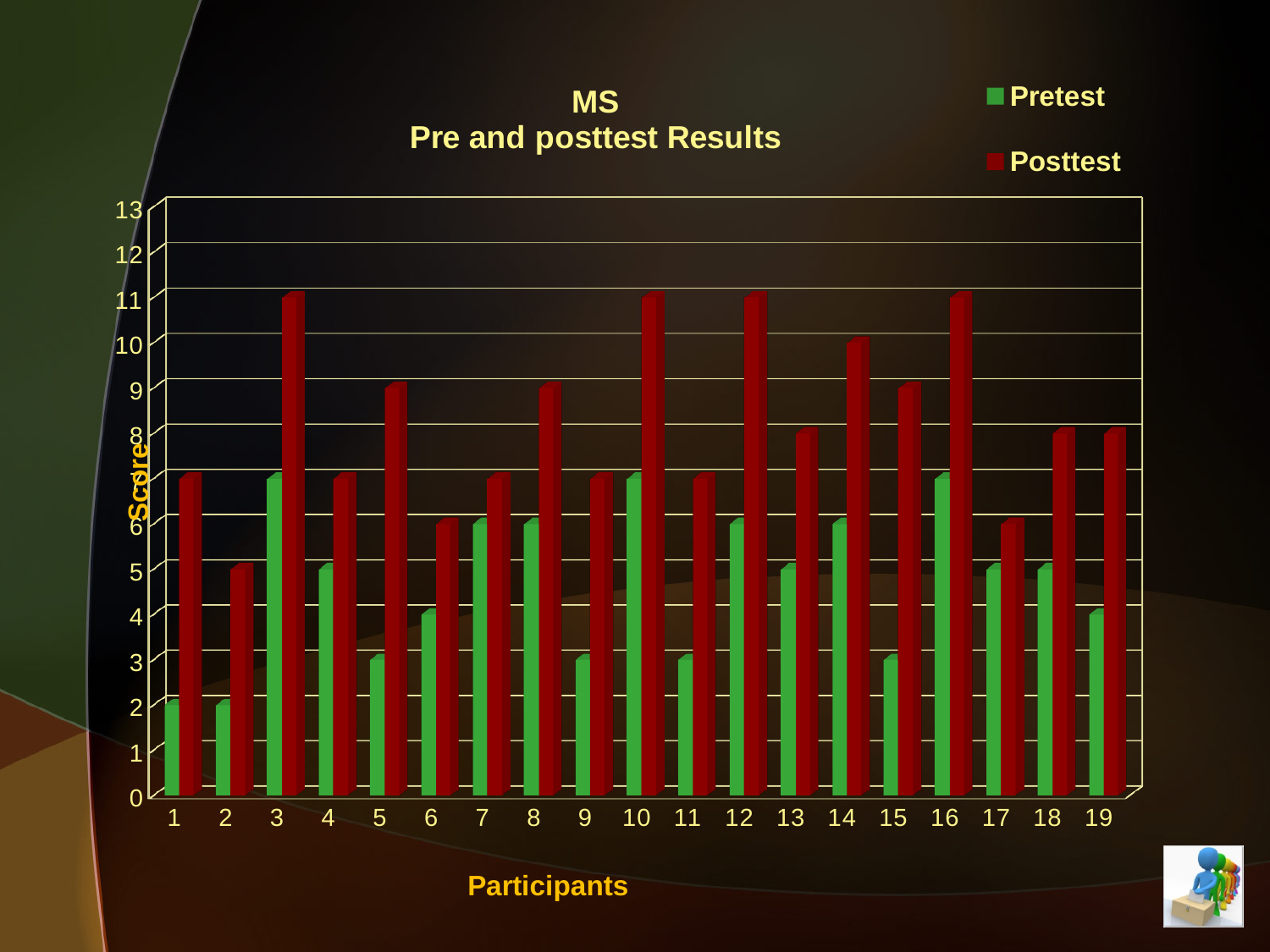
Which participant has the lowest Posttest score? 2 How many participants are shown on the x axis of the chart? 19 Is the Posttest value for participant 3 greater or less than 10? greater Is the Pretest value for participant 6 greater or less than 5? less For participant 5, which is larger, the Pretest or the Posttest score? Posttest How many series does the chart's legend list? 2 What is the label of the vertical axis of the chart? Score Which participant has the larger Pretest score, participant 3 or participant 5? 3 What kind of chart is shown on the slide? Bar chart Is the Posttest value for participant 14 greater or less than 8? greater What is the title of the chart? MS Pre and posttest Results